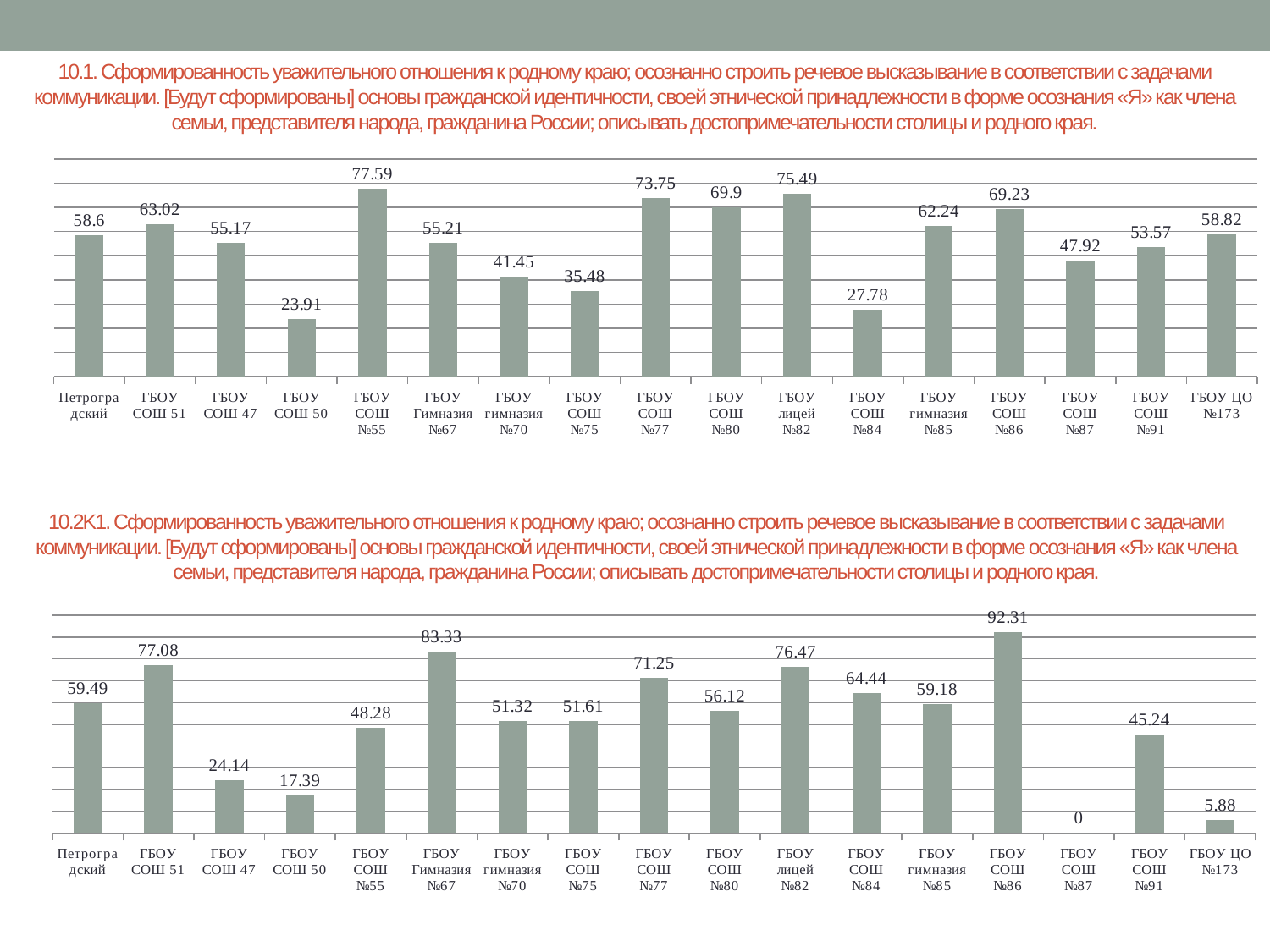
In the top chart, what is the value for Петроградский? 58.6 In the bottom chart, what is the difference between the values for ГБОУ Гимназия №67 and ГБОУ СОШ 51? 6.25 How many categories are shown in the bottom chart? 17 In the top chart, what is the difference between the values for ГБОУ СОШ №55 and ГБОУ СОШ 50? 53.68 In the bottom chart, which category has the lowest value? ГБОУ СОШ №87 What type of chart is the top chart? Bar chart In the bottom chart, what is the value for ГБОУ ЦО №173? 5.88 In the top chart, which category has the lowest value? ГБОУ СОШ 50 In the bottom chart, what is the value for ГБОУ СОШ №86? 92.31 In the top chart, which is larger: the value for ГБОУ СОШ №77 or the value for ГБОУ лицей №82? ГБОУ лицей №82 In the top chart, which category has the highest value? ГБОУ СОШ №55 In the top chart, what is the value for ГБОУ СОШ №55? 77.59